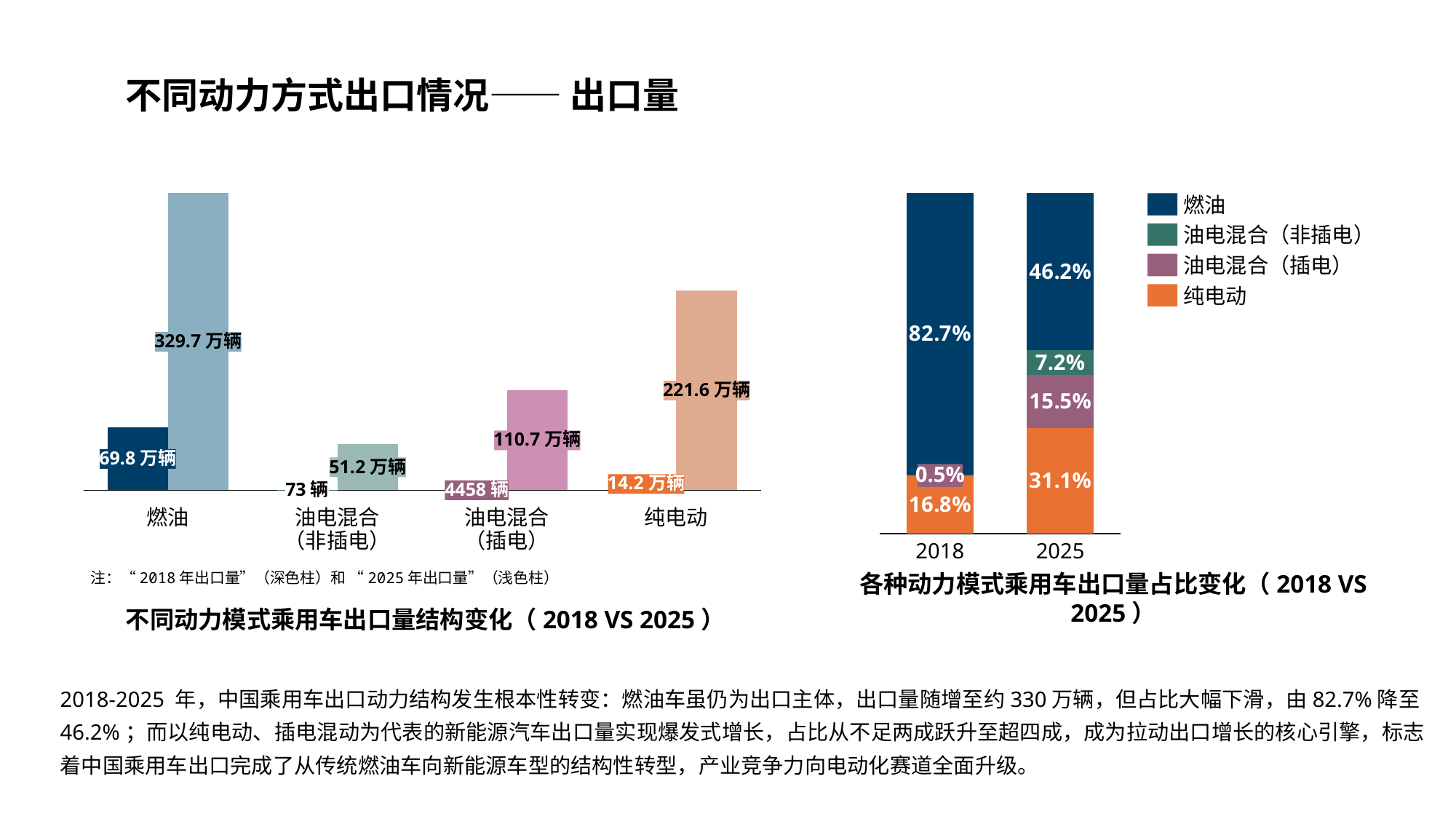
How many categories are shown on the x axis of the left chart (不同动力模式乘用车出口量结构变化)? 4 How many series does the legend of the right chart (各种动力模式乘用车出口量占比变化) list? 4 In the right chart (各种动力模式乘用车出口量占比变化), what is the share of 纯电动 in 2018? 16.8% In the right chart (各种动力模式乘用车出口量占比变化), by how many percentage points did the 燃油 share fall from 2018 to 2025? 36.5% In the left chart (不同动力模式乘用车出口量结构变化), what is the difference between the 2025 and 2018 export volumes for 燃油? 259.9 万辆 In the left chart (不同动力模式乘用车出口量结构变化), what is the 2018 export volume for 油电混合（非插电）? 73 辆 In the left chart (不同动力模式乘用车出口量结构变化), what is the 2018 export volume for 纯电动? 14.2 万辆 In the left chart (不同动力模式乘用车出口量结构变化), which category has the highest 2025 export volume? 燃油 In the right chart (各种动力模式乘用车出口量占比变化), what is the share of 燃油 in 2025? 46.2% In the left chart (不同动力模式乘用车出口量结构变化), what is the 2025 export volume for 燃油? 329.7 万辆 In the left chart (不同动力模式乘用车出口量结构变化), which is larger: the 2025 value for 油电混合（插电） or the 2025 value for 纯电动? 纯电动 In the left chart (不同动力模式乘用车出口量结构变化), which category has the lowest 2025 export volume? 油电混合（非插电）